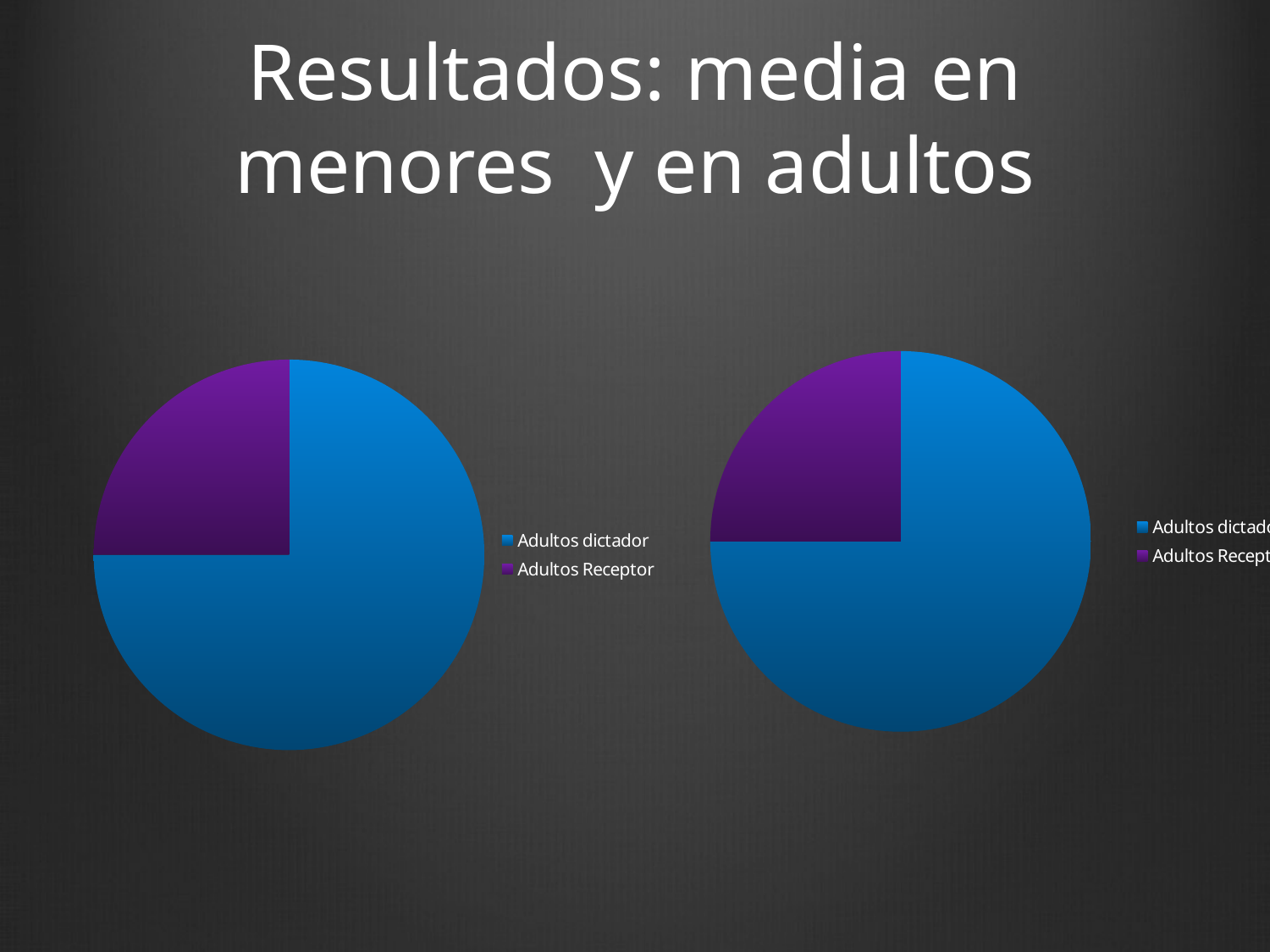
What kind of chart is the left chart on the slide? pie chart How many slices does the right pie chart have? 2 In the left pie chart, which category has the largest slice? Adultos dictador In the left pie chart, which slice is larger: Adultos dictador or Adultos Receptor? Adultos dictador In the right pie chart, which category has the largest slice? Adultos dictador How many slices does the left pie chart have? 2 What is the title of the slide containing the two pie charts? Resultados: media en menores y en adultos In the left pie chart, what colour is the Adultos Receptor slice? purple In the left pie chart, which category has the smallest slice? Adultos Receptor In the right pie chart, which category has the smallest slice? Adultos Receptor How many entries does the legend of the left pie chart list? 2 What kind of chart is the right chart on the slide? pie chart